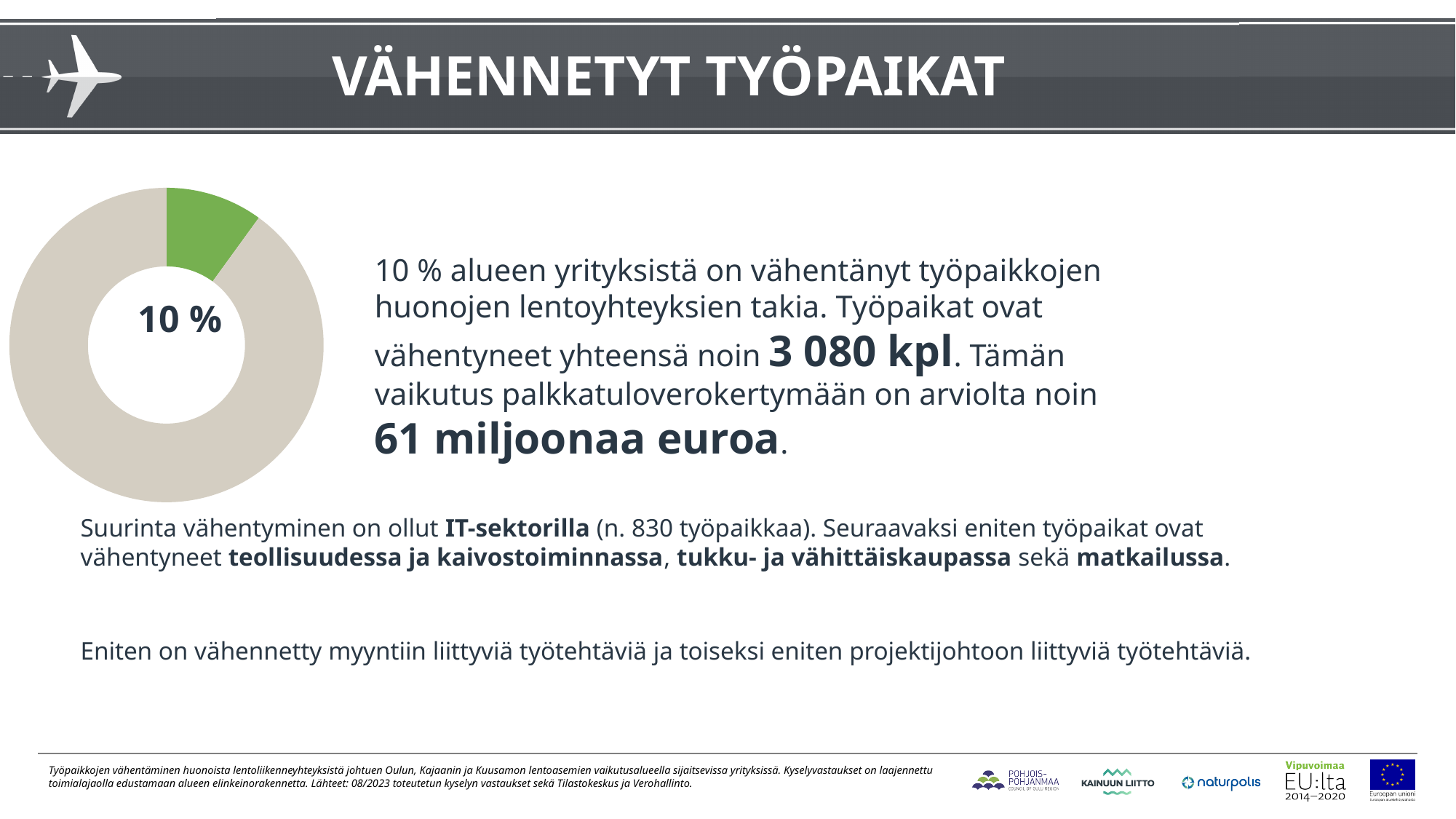
What kind of chart is shown on the left of the slide? Donut (pie) chart How many slices does the donut chart have? 2 Is the green slice of the donut chart greater or less than 50 % of the whole? less What share of the donut chart does the green slice represent? 10 % What percentage is printed in the centre of the donut chart? 10 % Which slice of the donut chart is larger, the green one or the grey one? The grey one What is the title of the slide containing the donut chart? VÄHENNETYT TYÖPAIKAT What colour is the slice representing the 10 % share in the donut chart? Green